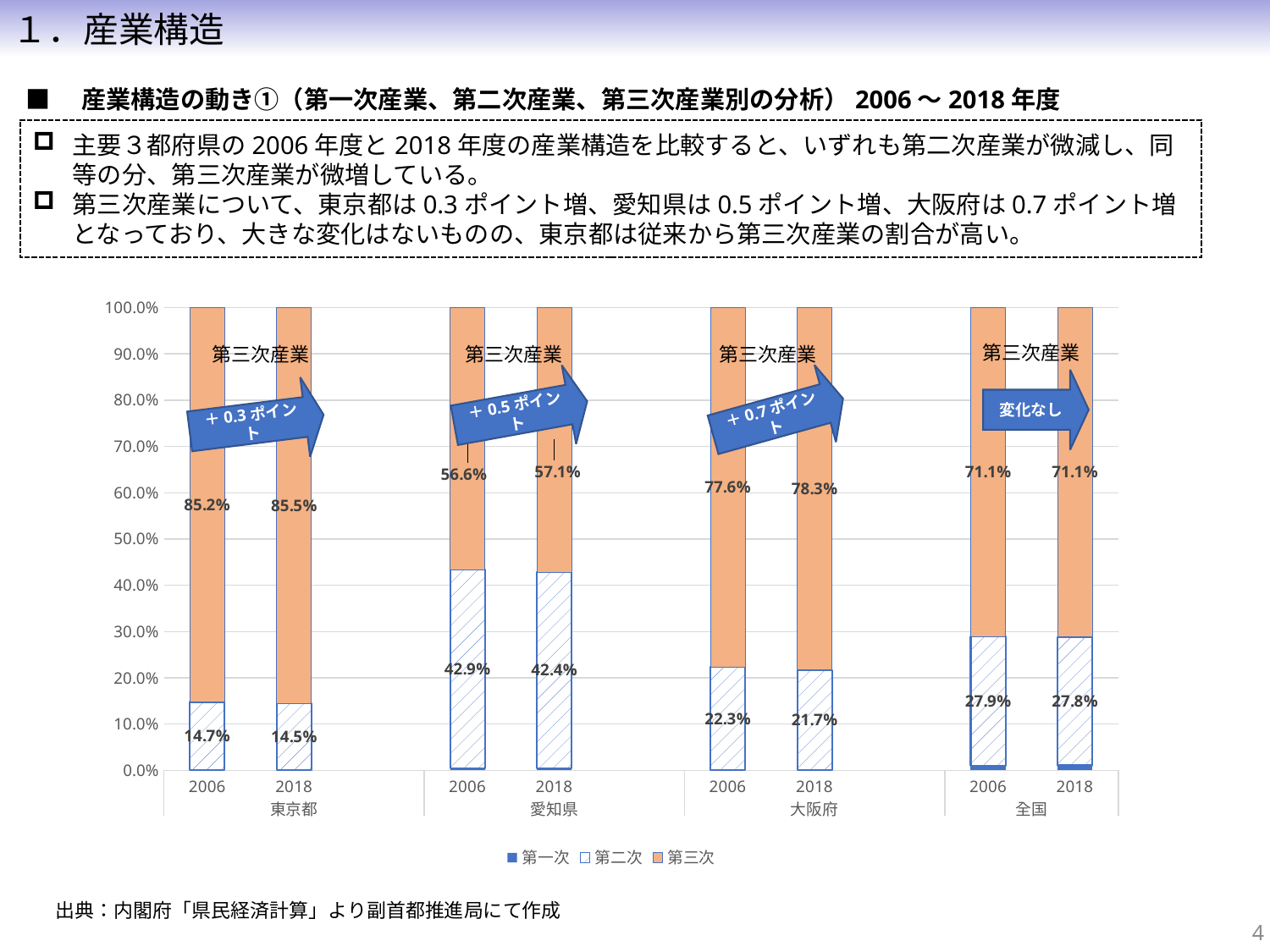
What kind of chart is shown on the slide? stacked bar chart Which is larger in 2018: the 第二次 share for 愛知県 or for 大阪府? 愛知県 How many stacked bars are plotted in the chart? 8 What is the 第三次 share for 東京都 in 2018? 85.5% Does the 第二次 share for 東京都 rise or fall from 2006 to 2018? fall Which region has the lowest 第三次 share in 2006? 愛知県 Is the 第一次 share for 全国 in 2006 greater or less than 10.0%? less Which region has the highest 第三次 share in 2018? 東京都 What is the 第二次 share for 愛知県 in 2006? 42.9% By how many points did the 第三次 share for 大阪府 change from 2006 to 2018? 0.7 ポイント What is the 第二次 share for 全国 in 2018? 27.8% How many series does the legend list? 3